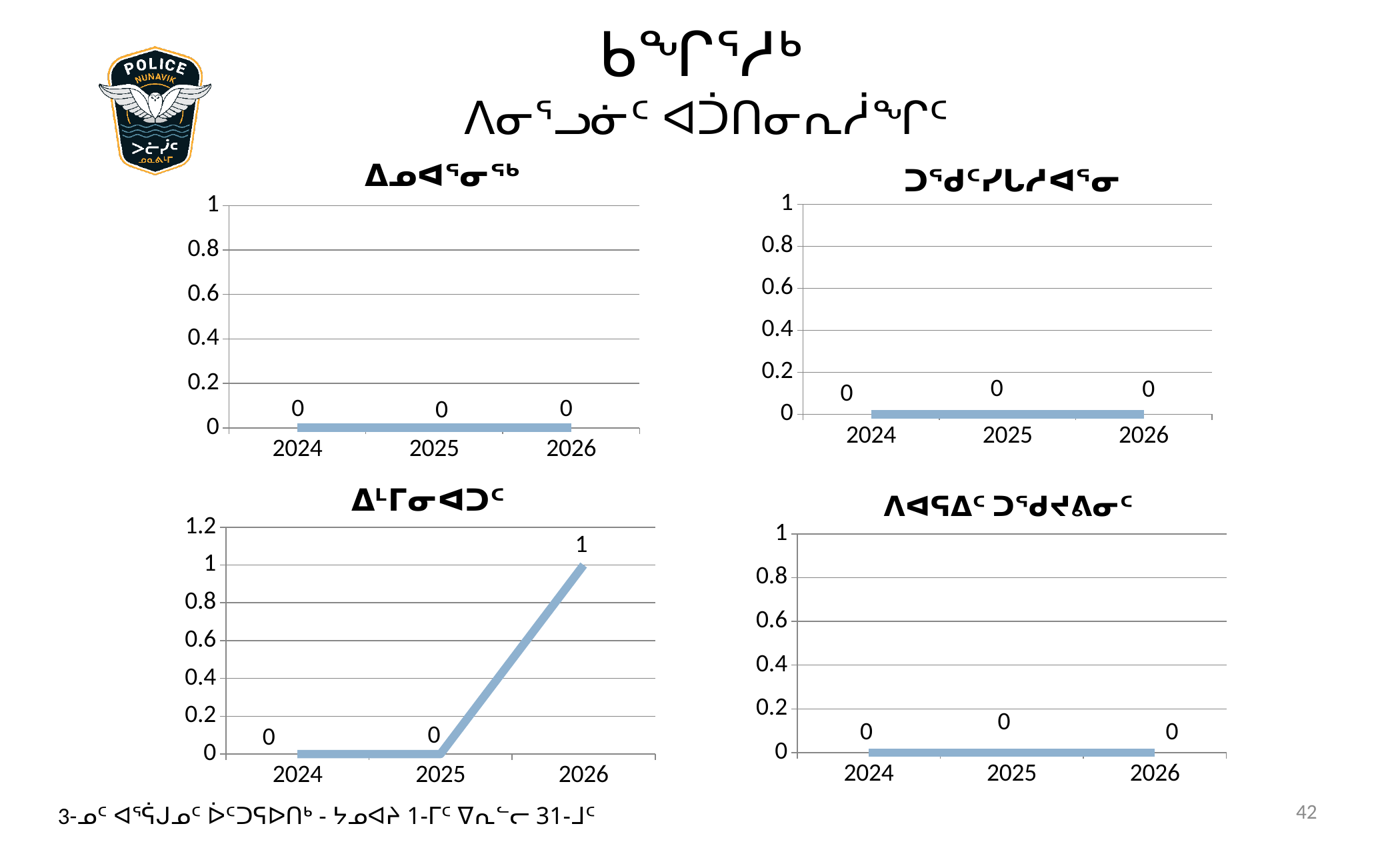
In the bottom-left chart, what is the value for 2025? 0 In the bottom-left chart, what is the value for 2026? 1 In the bottom-left chart, do the values rise or fall from 2025 to 2026? rise In the top-right chart, what is the value for 2026? 0 How many charts are on the slide? 4 How many years are shown on the x axis of the top-right chart? 3 In the bottom-left chart, which year has the highest value? 2026 In the top-left chart, what is the value for 2024? 0 In the bottom-left chart, which is larger, the value for 2024 or the value for 2026? 2026 In the bottom-left chart, what is the difference between the values for 2026 and 2025? 1 What kind of chart is the bottom-left chart? line chart In the bottom-right chart, what is the value for 2025? 0